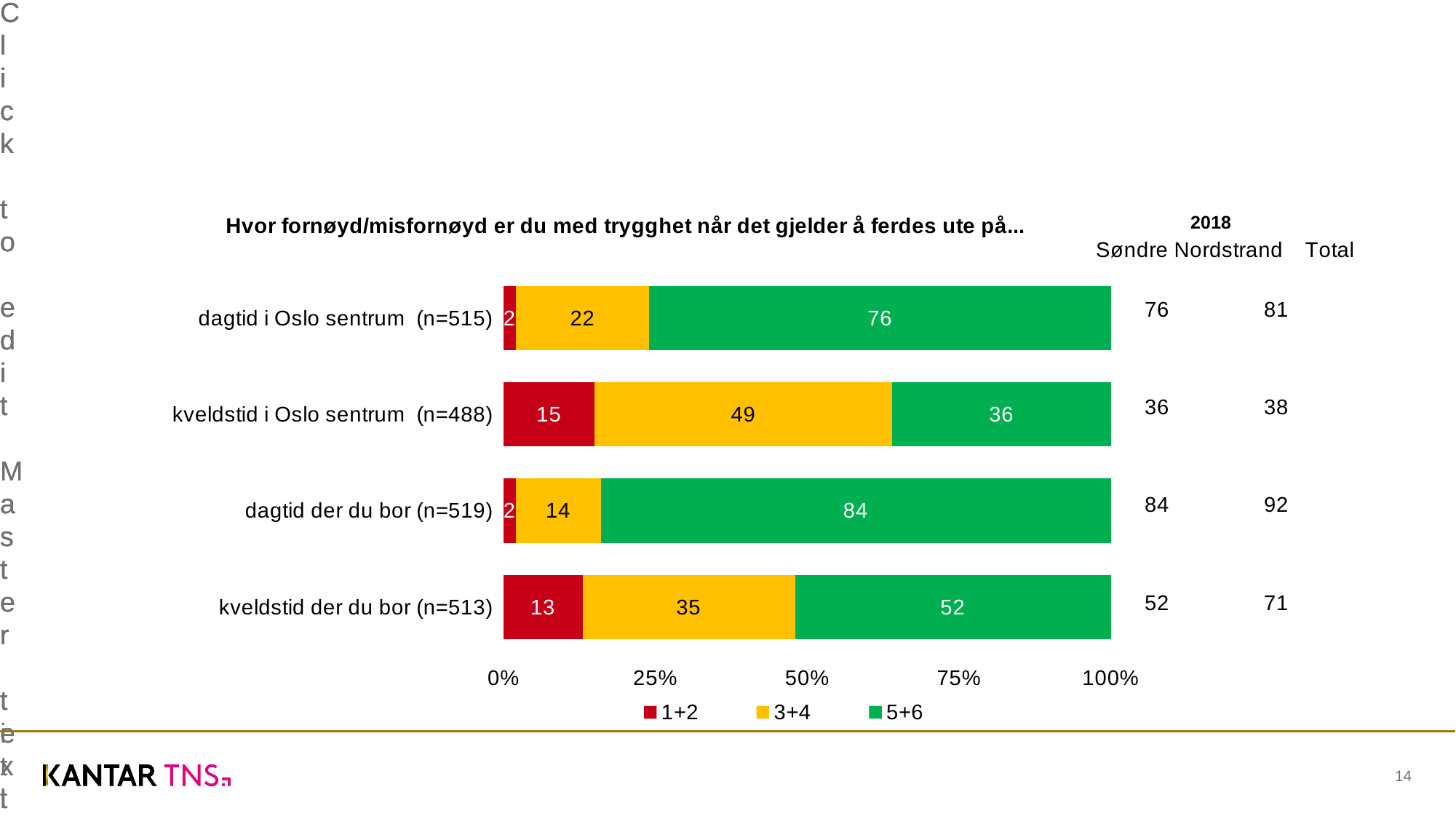
Which series is shown in green in the legend? 5+6 What is the value of the 1+2 series for 'kveldstid i Oslo sentrum (n=488)'? 15 Which category has the lowest value for the 5+6 series? kveldstid i Oslo sentrum (n=488) What is the value of the 3+4 series for 'kveldstid der du bor (n=513)'? 35 Which is larger: the 3+4 value for 'kveldstid i Oslo sentrum (n=488)' or for 'kveldstid der du bor (n=513)'? kveldstid i Oslo sentrum (n=488) How many categories (bars) does the chart show? 4 What is the difference between the 5+6 values for 'dagtid der du bor (n=519)' and 'kveldstid der du bor (n=513)'? 32 What kind of chart is shown on the slide? Stacked bar chart What is the value of the 5+6 series for 'dagtid i Oslo sentrum (n=515)'? 76 Which category has the highest value for the 5+6 series? dagtid der du bor (n=519) How many series does the legend list? 3 What is the total of the stacked bar for 'kveldstid i Oslo sentrum (n=488)'? 100